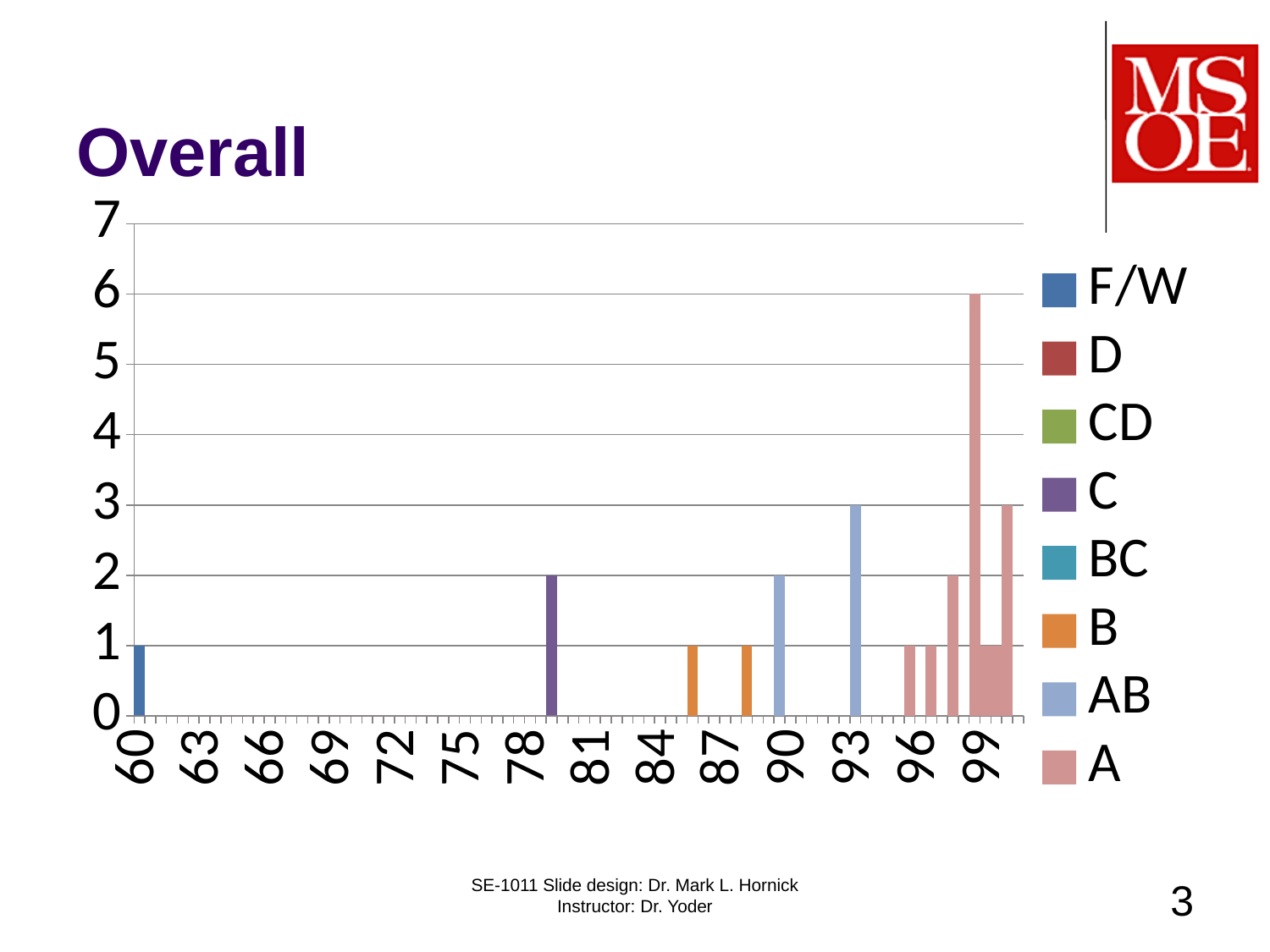
Which is larger, the AB bar at 93 or the AB bar at 90? the AB bar at 93 Which series has the tallest bar in the chart? A Which legend entry is listed last? A What is the value of the AB bar at 93? 3 What is the value of the AB bar at 90? 2 What is the title of the chart? Overall How many series does the legend list? 8 What is the value of the F/W bar at 60? 1 What is the difference between the AB bar at 93 and the F/W bar at 60? 2 Is the tallest bar in the chart greater or less than 5? greater What type of chart is shown on the slide? bar chart What is the height of the tallest bar in the chart? 6